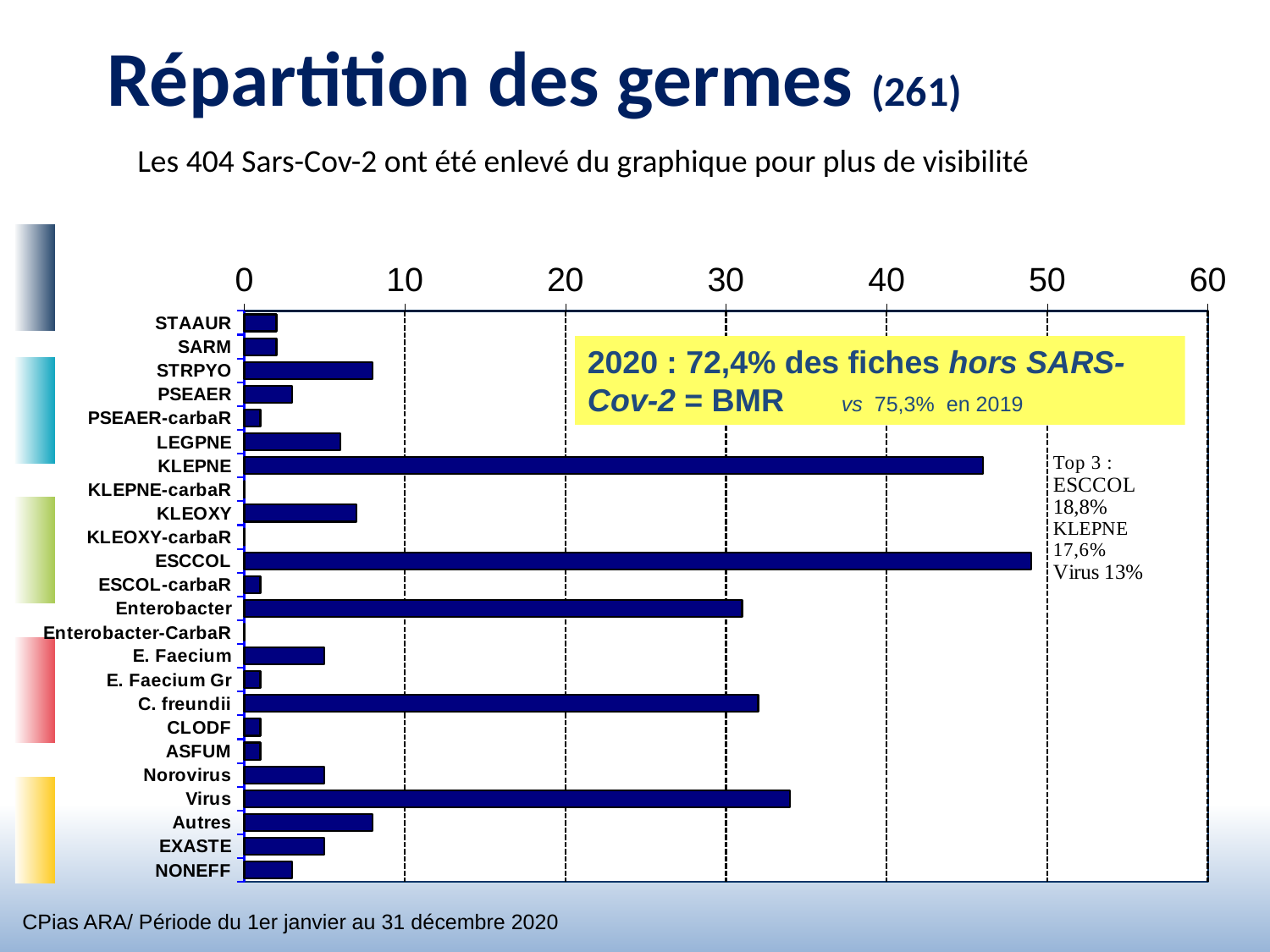
What kind of chart is shown on the slide? bar chart What is the highest value shown on the horizontal axis of the chart? 60 Is the value for KLEPNE greater or less than 40? greater Is the value for Virus greater or less than 40? less Is the value for STRPYO greater or less than 10? less Which is larger, the value for Enterobacter or the value for LEGPNE? Enterobacter How many categories are listed on the vertical axis of the chart? 24 What is the title of the slide containing the chart? Répartition des germes (261) Which is larger, the value for KLEPNE or the value for Virus? KLEPNE Which category has the longest bar in the chart? ESCCOL